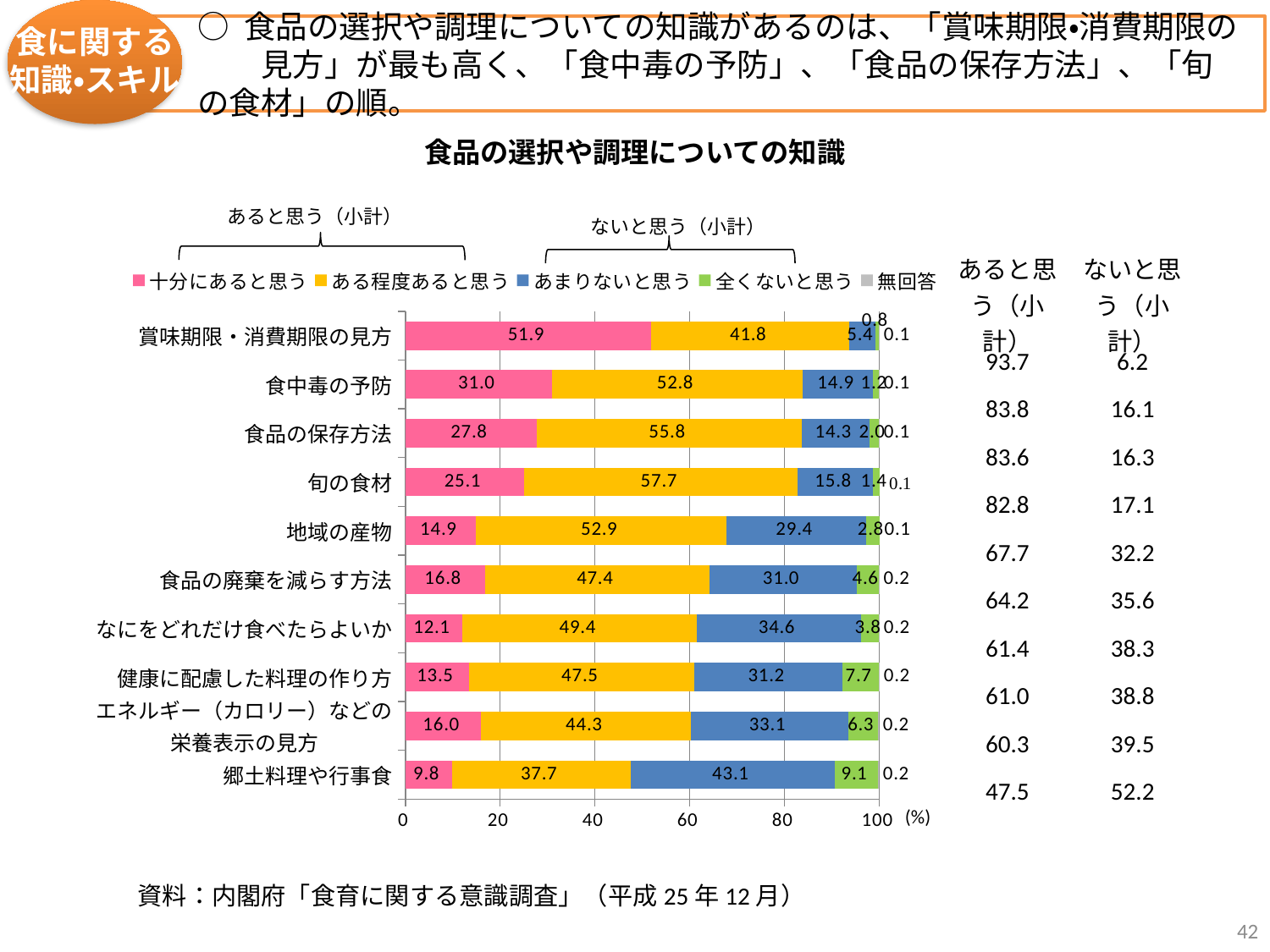
What is the value of 全くないと思う for 健康に配慮した料理の作り方? 7.7 How many series does the legend list? 5 What is the title of the chart? 食品の選択や調理についての知識 What is the value of ある程度あると思う for 旬の食材? 57.7 What is the value of 十分にあると思う for 賞味期限・消費期限の見方? 51.9 What is the value of あまりないと思う for 郷土料理や行事食? 43.1 How many categories are plotted on the chart? 10 Which is larger: the あまりないと思う value for 地域の産物 or for 食品の廃棄を減らす方法? 食品の廃棄を減らす方法 What type of chart is shown on the slide? Stacked bar chart What is the difference between the ある程度あると思う values for 食品の保存方法 and 食中毒の予防? 3.0 Which category has the lowest value for 十分にあると思う? 郷土料理や行事食 Which category has the highest value for 十分にあると思う? 賞味期限・消費期限の見方